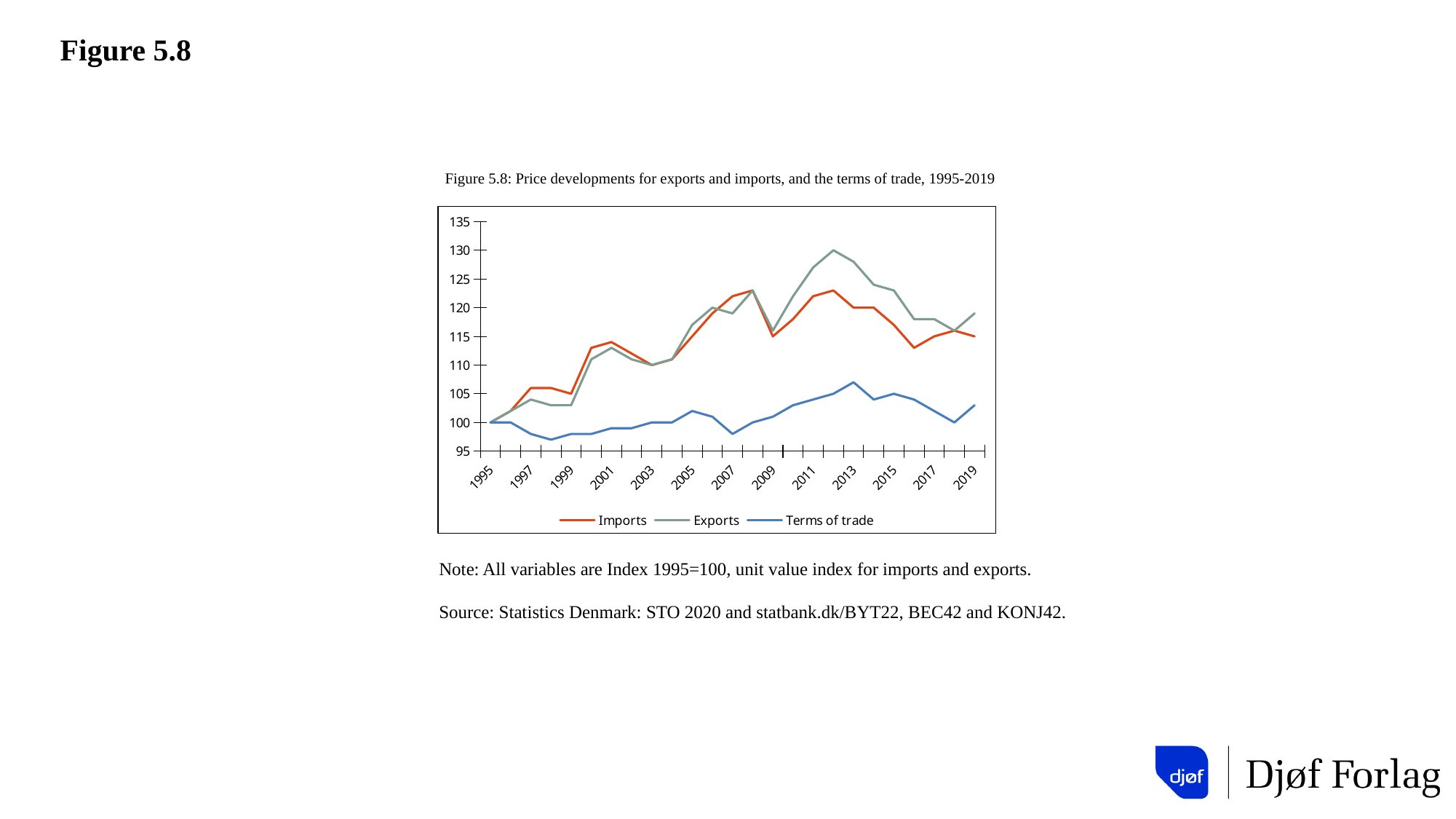
What are the three series named in the chart's legend? Imports, Exports, Terms of trade How many series does the legend of the chart list? 3 Is the value for Exports in 2012 greater or less than 125? greater What is the index value of Imports, Exports and Terms of trade in 1995? 100 Is the value for Terms of trade in 1997 greater or less than 100? less Does the Exports line rise or fall between 2009 and 2012? Rises Is the value for Imports in 2016 greater or less than 115? less Which series has the highest value in 2019? Exports What kind of chart is shown in Figure 5.8? Line chart In 2012, which is larger: Exports or Imports? Exports Which series has the lowest value in 2013? Terms of trade In 1997, which is larger: Imports or Exports? Imports